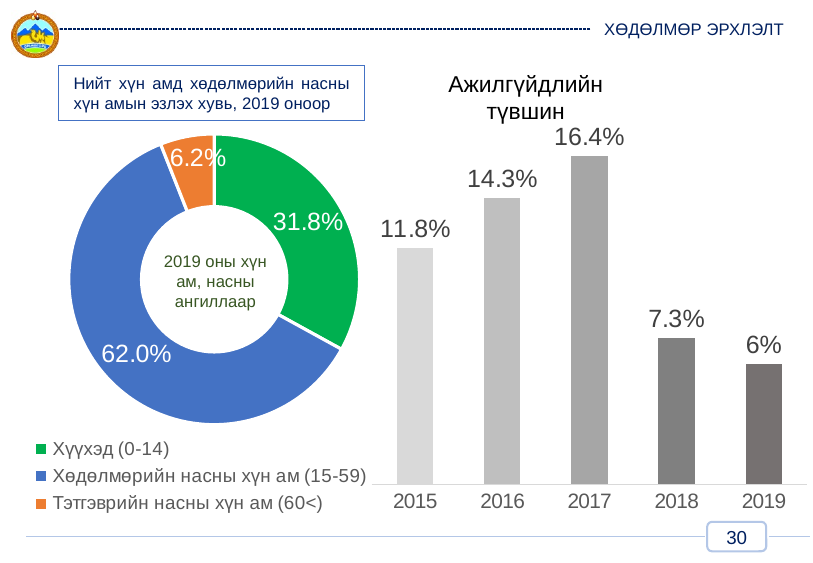
In the bar chart titled "Ажилгүйдлийн түвшин", which year has the lowest value? 2019 How many categories does the legend of the donut chart on the left list? 3 In the bar chart titled "Ажилгүйдлийн түвшин", do the values rise or fall from 2017 to 2019? fall What kind of chart is the chart on the right of the slide? bar chart In the donut chart on the left, what is the value for "Тэтгэврийн насны хүн ам (60<)"? 6.2% In the donut chart on the left, what share does "Хөдөлмөрийн насны хүн ам (15-59)" have? 62.0% In the bar chart titled "Ажилгүйдлийн түвшин", which year has the highest value? 2017 In the bar chart titled "Ажилгүйдлийн түвшин", what is the value for 2019? 6% In the bar chart titled "Ажилгүйдлийн түвшин", what is the value for 2017? 16.4% How many years are shown in the bar chart titled "Ажилгүйдлийн түвшин"? 5 In the bar chart titled "Ажилгүйдлийн түвшин", which is larger, the value for 2015 or the value for 2016? 2016 In the bar chart titled "Ажилгүйдлийн түвшин", what is the difference between the values for 2017 and 2018? 9.1%